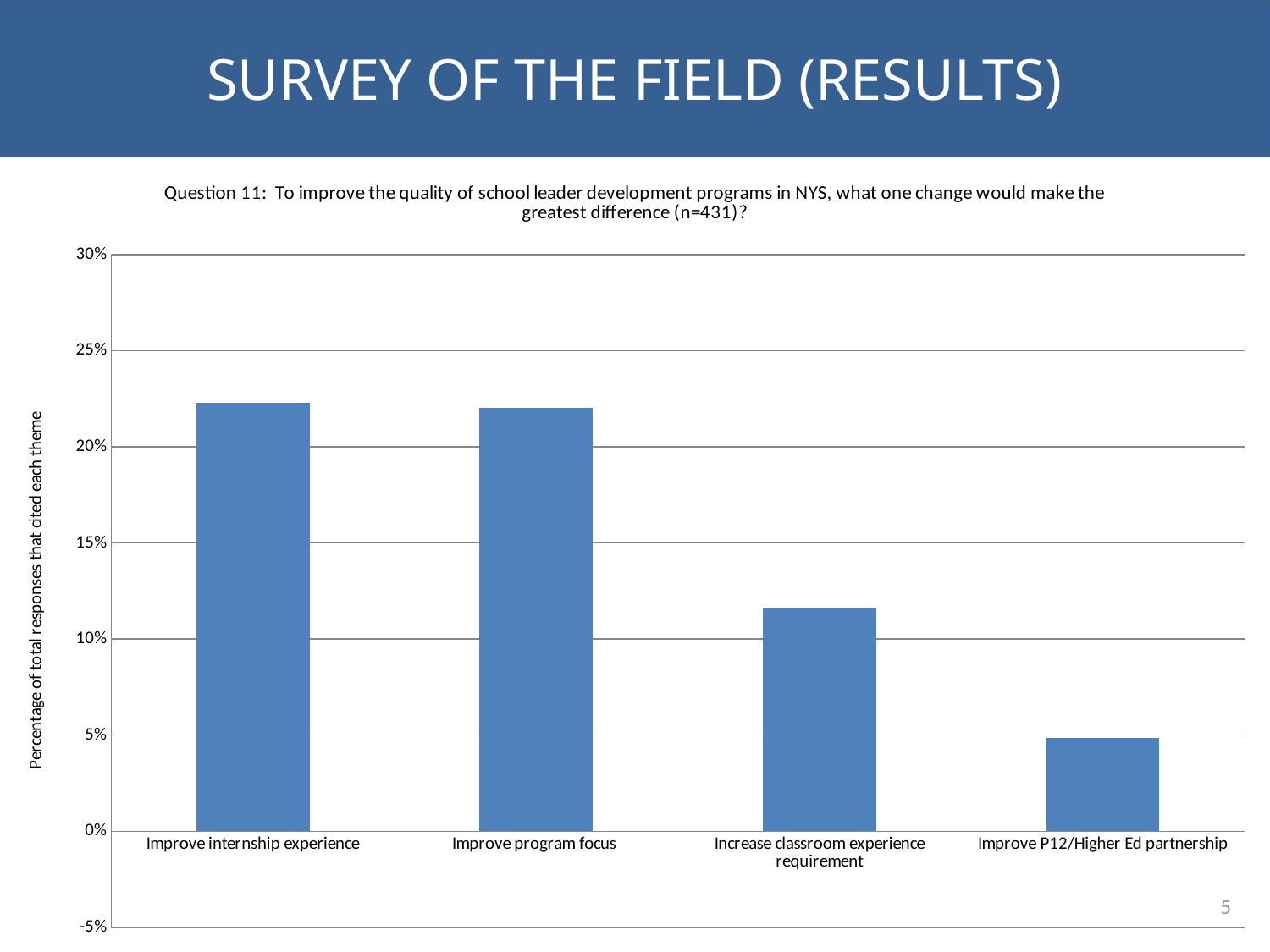
What kind of chart is shown on the slide? bar chart Is the value for Improve program focus greater or less than 25%? less Is the value for Improve internship experience greater or less than 20%? greater Do the bar values rise or fall from left to right along the x axis? fall What is the label of the vertical axis of the chart? Percentage of total responses that cited each theme Is the value for Increase classroom experience requirement greater or less than 10%? greater Which is larger: the value for Increase classroom experience requirement or the value for Improve P12/Higher Ed partnership? Increase classroom experience requirement Which is larger: the value for Improve internship experience or the value for Increase classroom experience requirement? Improve internship experience Which category has the lowest value in the chart? Improve P12/Higher Ed partnership How many categories are shown on the x axis of the chart? 4